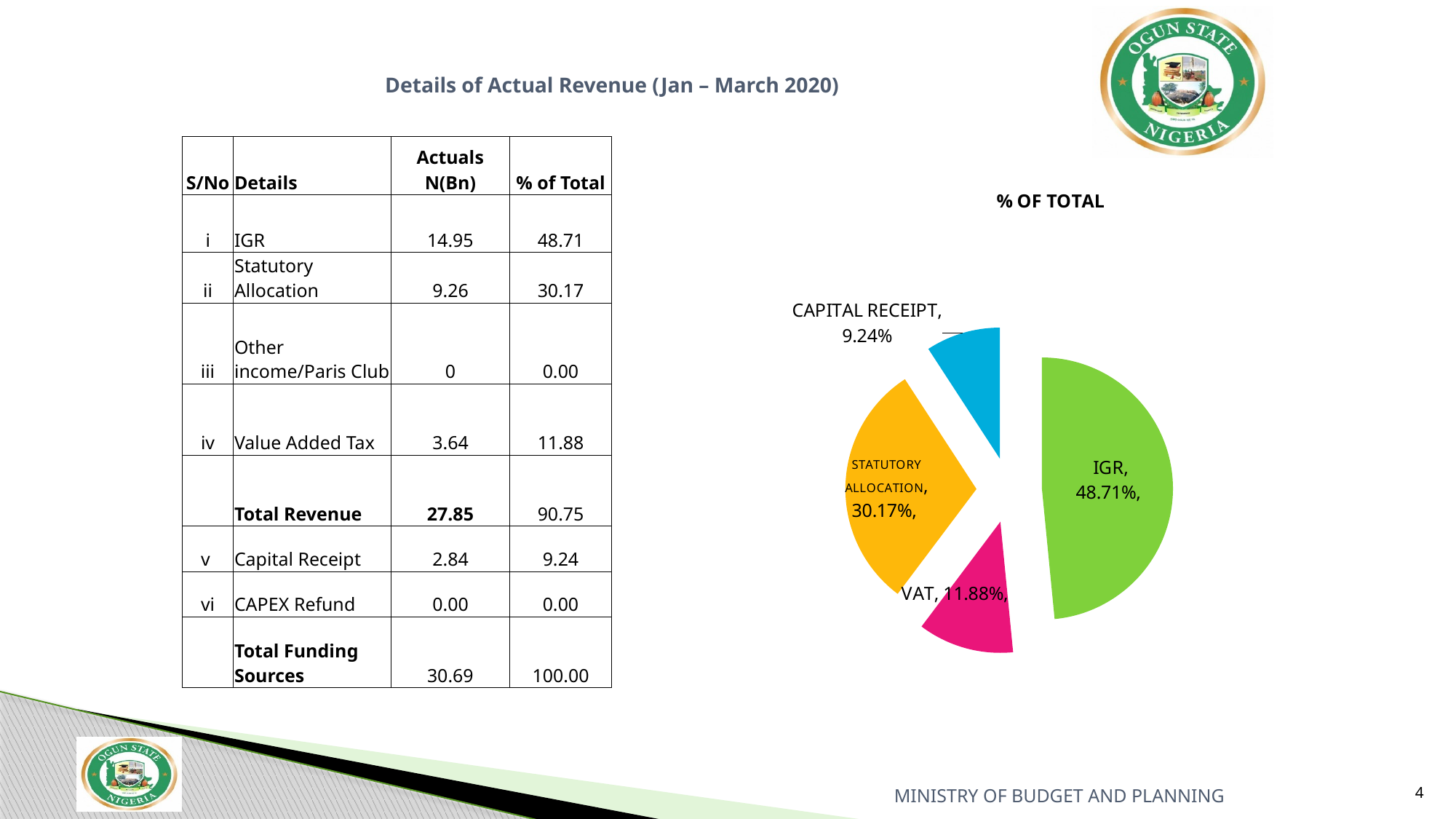
What percentage does the IGR slice show in the pie chart? 48.71% What is the difference in percentage points between the IGR slice and the STATUTORY ALLOCATION slice? 18.54 What percentage does the STATUTORY ALLOCATION slice show in the pie chart? 30.17% What colour is the IGR slice in the pie chart? green Which is larger in the pie chart, the VAT slice or the CAPITAL RECEIPT slice? VAT What percentage does the CAPITAL RECEIPT slice show in the pie chart? 9.24% How many labelled slices does the pie chart have? 4 What is the title of the chart? % OF TOTAL Which slice of the pie chart is the largest? IGR What type of chart is shown on the slide? pie chart What percentage does the VAT slice show in the pie chart? 11.88% Which slice of the pie chart is the smallest? CAPITAL RECEIPT